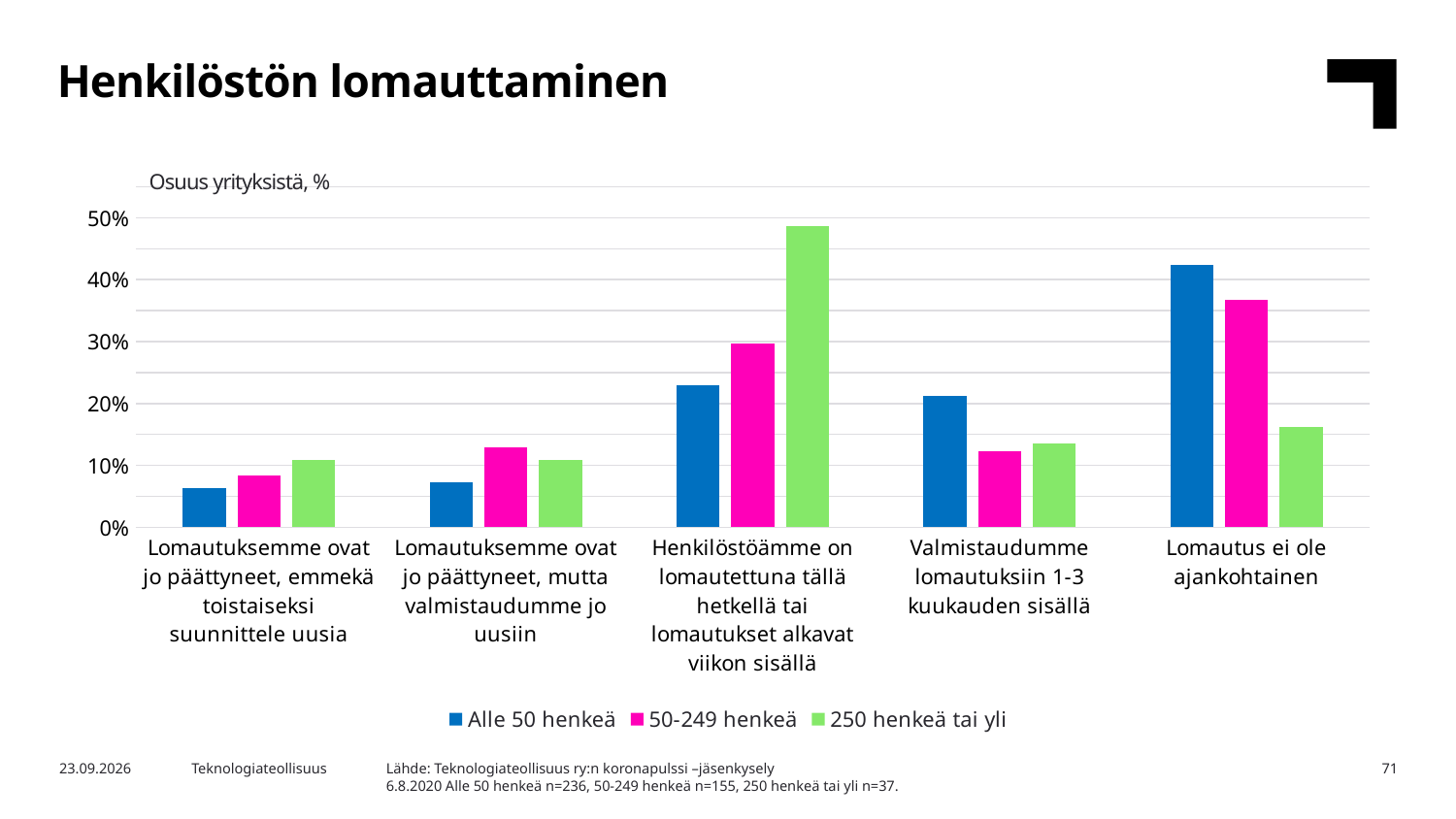
In the category 'Valmistaudumme lomautuksiin 1-3 kuukauden sisällä', which series has the larger value: 'Alle 50 henkeä' or '50-249 henkeä'? Alle 50 henkeä In the category 'Lomautus ei ole ajankohtainen', which series has the larger value: 'Alle 50 henkeä' or '50-249 henkeä'? Alle 50 henkeä Which category has the lowest value for the series '50-249 henkeä'? Lomautuksemme ovat jo päättyneet, emmekä toistaiseksi suunnittele uusia What kind of chart is shown on the slide? bar chart How many categories are shown on the x axis? 5 How many series does the legend list? 3 What label is shown above the vertical axis of the chart? Osuus yrityksistä, % Is the value for '250 henkeä tai yli' in the category 'Henkilöstöämme on lomautettuna tällä hetkellä tai lomautukset alkavat viikon sisällä' greater or less than 40%? greater Which category has the highest value for the series 'Alle 50 henkeä'? Lomautus ei ole ajankohtainen What is the title of the chart on the slide? Henkilöstön lomauttaminen Is the value for '50-249 henkeä' in the category 'Lomautus ei ole ajankohtainen' greater or less than 40%? less Which category has the highest value for the series '250 henkeä tai yli'? Henkilöstöämme on lomautettuna tällä hetkellä tai lomautukset alkavat viikon sisällä